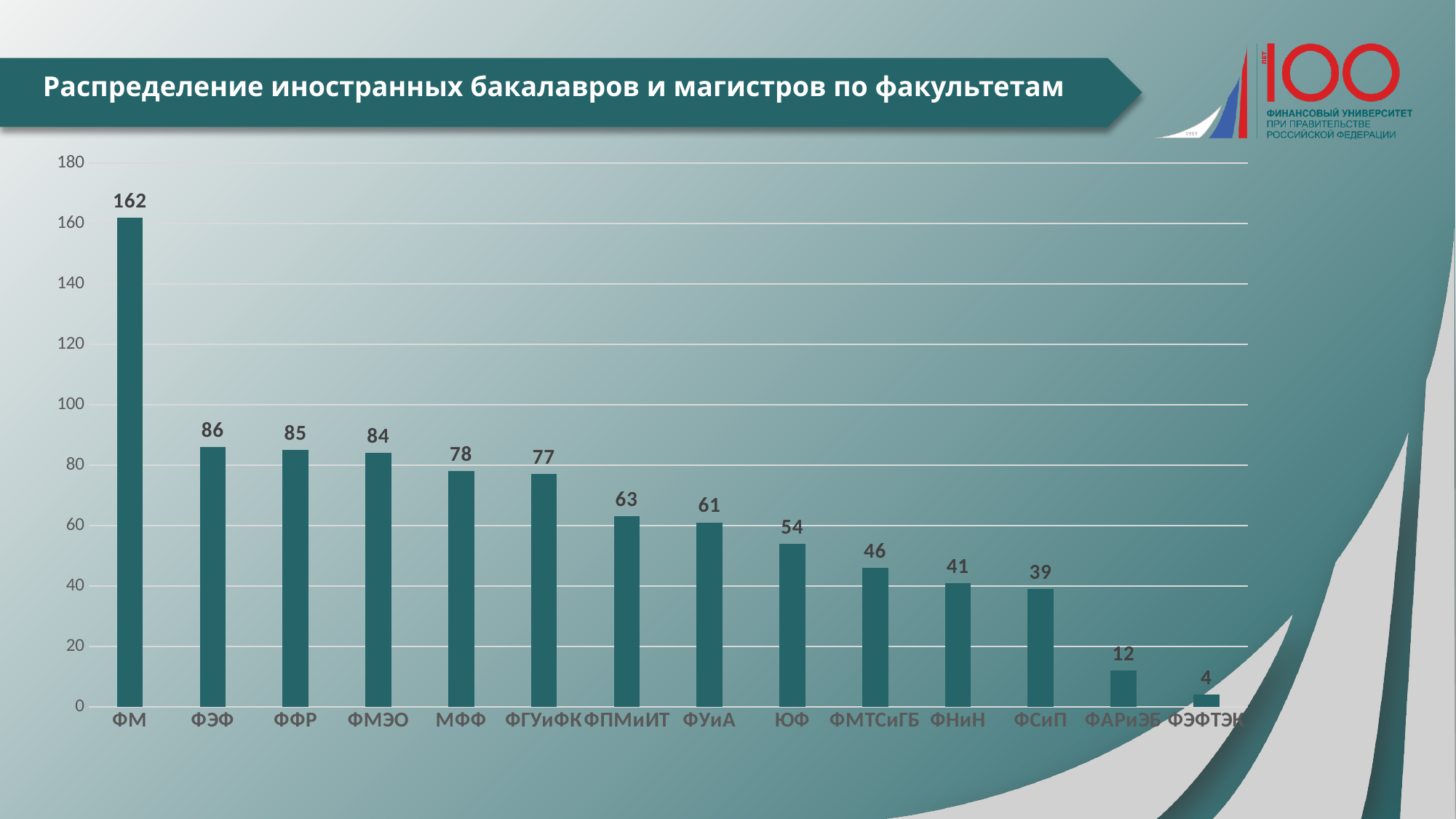
What is the value for ФАРиЭБ? 12 What is the value for ФМТСиГБ? 46 What kind of chart is shown on the slide? bar chart What is the difference between the values for ФМ and ФЭФ? 76 How many faculties are shown on the chart? 14 Which faculty has the highest value? ФМ Is the value for ФУиА greater or less than 80? less What is the title of the chart? Распределение иностранных бакалавров и магистров по факультетам What is the lowest value shown on the chart? 4 Which is larger, the value for ЮФ or the value for ФНиН? ЮФ What is the value for ФПМиИТ? 63 What is the value for ФМ? 162